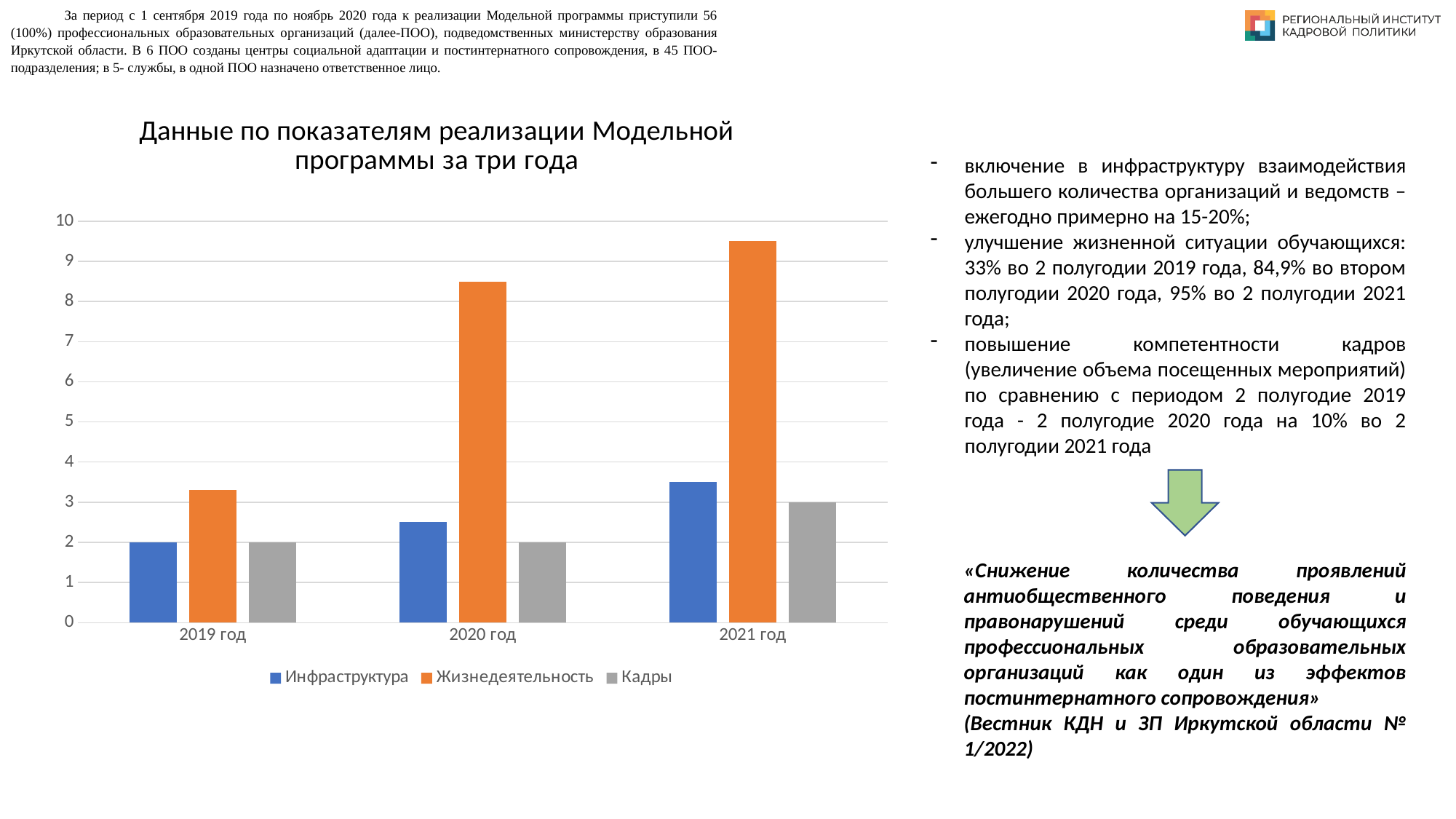
In 2021 год, which is larger: Инфраструктура or Кадры? Инфраструктура Is the value for Инфраструктура in 2021 год greater or less than 3? greater Is the value for Жизнедеятельность in 2019 год greater or less than 4? less Does the value for Инфраструктура rise or fall from 2019 год to 2021 год? rise In which year is the value for Жизнедеятельность the highest? 2021 год What is the value for Инфраструктура in 2019 год? 2 How many series does the chart legend list? 3 Is the value for Жизнедеятельность in 2020 год greater or less than 8? greater How many years (categories) are shown on the x axis of the chart? 3 What kind of chart is shown on the slide? bar chart What is the difference between the Кадры value in 2021 год and in 2019 год? 1 What is the value for Кадры in 2021 год? 3